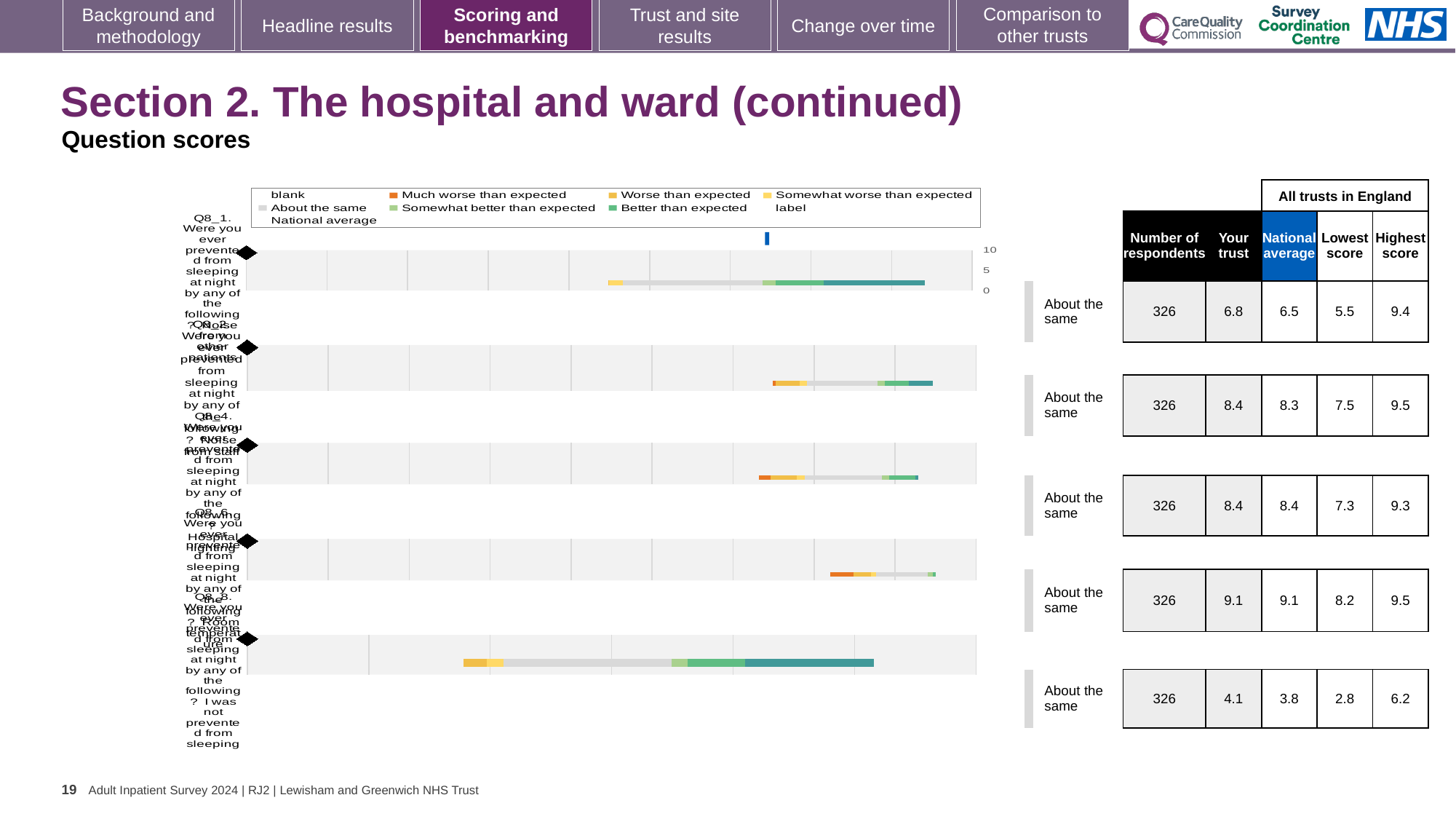
What is the number of respondents shown for the first question row? 326 What colour does the legend use for 'Much worse than expected'? Orange What benchmark label is shown next to every question row in the chart? About the same For the first question row, which is larger: the 'Your trust' score or the national average? Your trust (6.8) What is the 'Your trust' score for the first question row (Q8_1)? 6.8 What kind of chart is used to show the question scores on this slide? Bar chart For the bottom question row, what is the difference between the 'Your trust' score (4.1) and the national average (3.8)? 0.3 What is the highest score among all trusts in England for the bottom question row? 6.2 What is the national average for the fifth (bottom) question row? 3.8 How many question rows (bars) are plotted in the chart? 5 Which question row has the highest 'Your trust' score? The fourth row (9.1) Which question row has the lowest 'Your trust' score? The fifth (bottom) row (4.1)